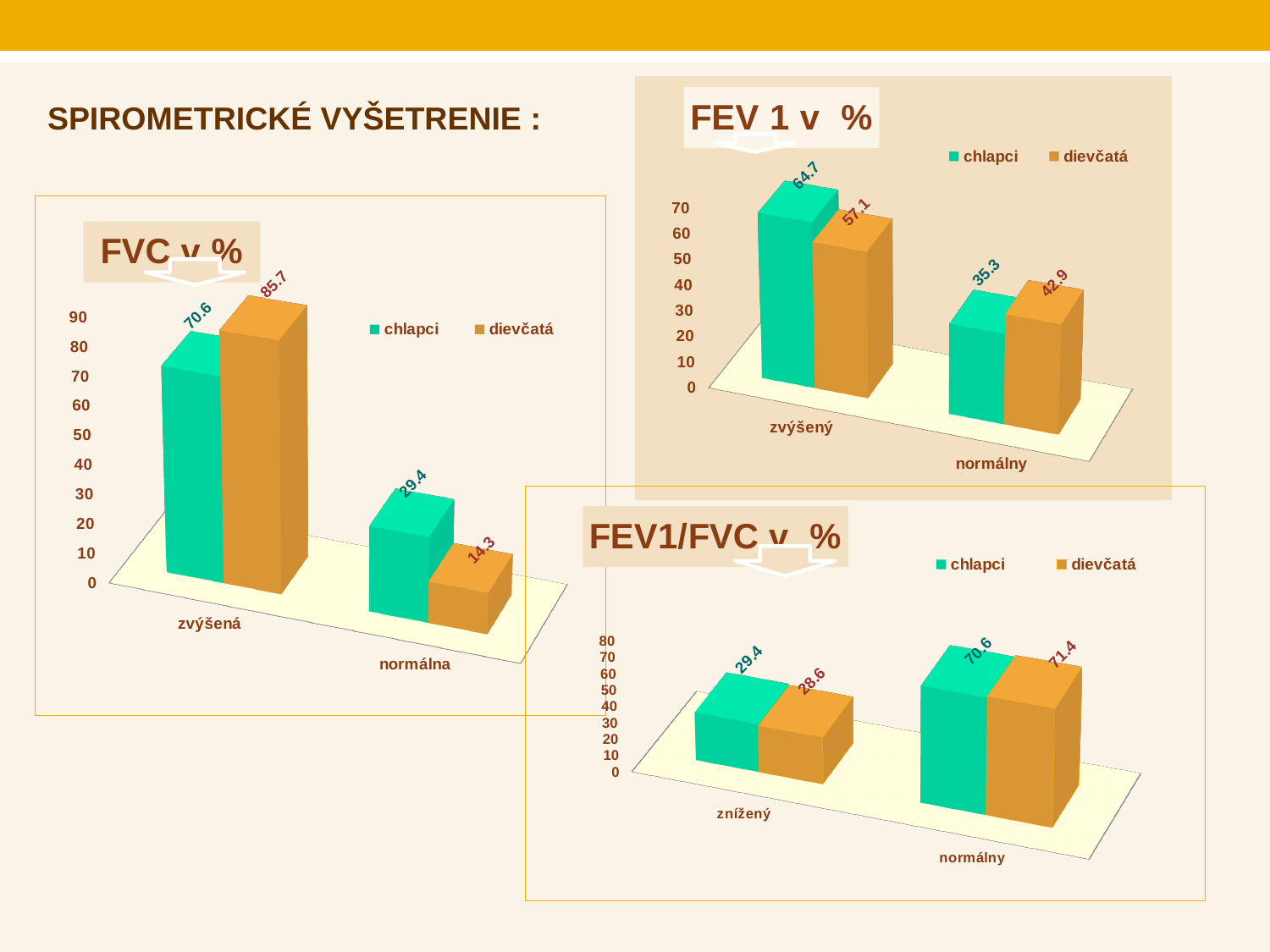
In the FVC v % chart, which series has the higher value in the normálna category? chlapci In the FEV 1 v % chart, what is the value for chlapci in the normálny category? 35.3 In the FEV 1 v % chart, which category has the highest value for chlapci? zvýšený In the FEV1/FVC v % chart, what is the value for chlapci in the znížený category? 29.4 In the FVC v % chart, what is the difference between dievčatá and chlapci in the zvýšená category? 15.1 In the FEV 1 v % chart, what is the value for dievčatá in the zvýšený category? 57.1 In the FVC v % chart, what is the value for dievčatá in the normálna category? 14.3 In the FEV 1 v % chart, what is the difference between chlapci and dievčatá in the zvýšený category? 7.6 How many series does the legend of the FEV1/FVC v % chart list? 2 In the FEV1/FVC v % chart, what is the value for dievčatá in the normálny category? 71.4 In the FVC v % chart, what is the value for chlapci in the zvýšená category? 70.6 What type of chart is the FVC v % chart? bar chart